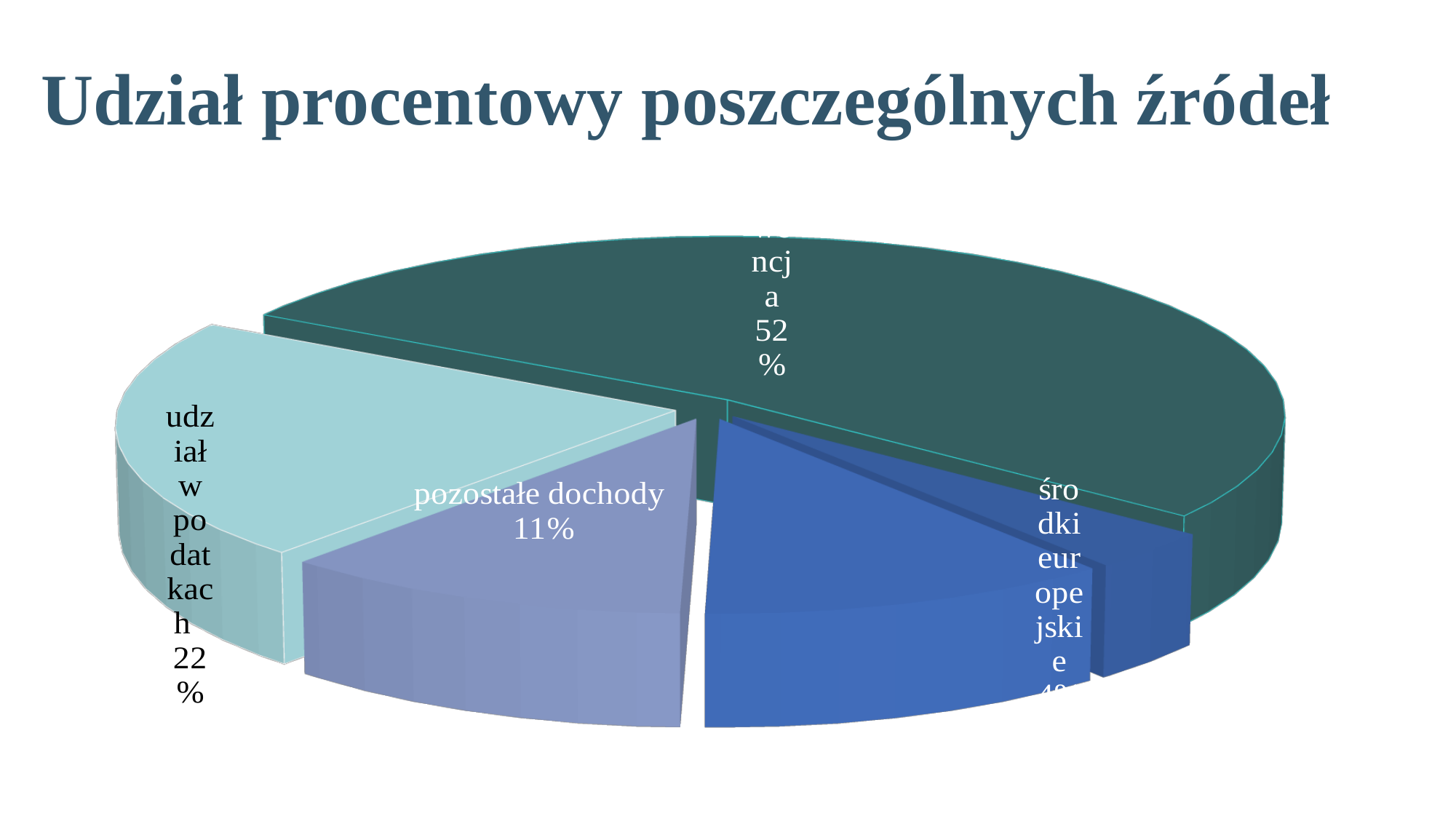
What colour is the "pozostałe dochody" slice? Light purple What percentage share does the slice "pozostałe dochody" have? 11% What percentage share does the slice "udział w podatkach" have? 22% What share of the pie does "udział w podatkach" represent? 22% Which slice is larger: "udział w podatkach" or "pozostałe dochody"? udział w podatkach By how many percentage points does "udział w podatkach" exceed "pozostałe dochody"? 11 percentage points What type of chart is shown on the slide? Pie chart What is the title of the slide? Udział procentowy poszczególnych źródeł What is the largest percentage share shown on the pie chart? 52% How many slices does the pie chart have? 5 Which slice has the smallest share of the pie? środki europejskie